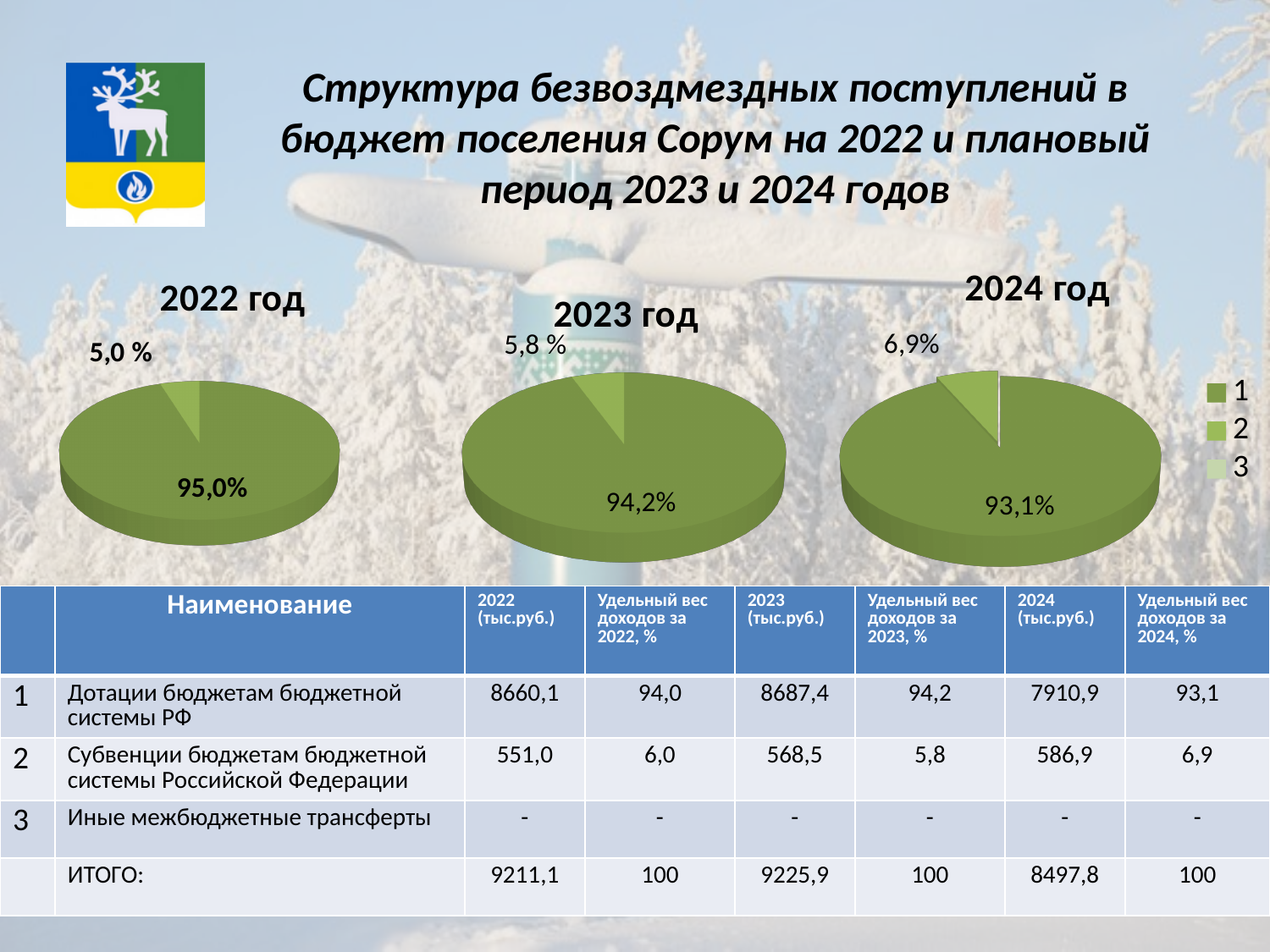
Which of the three pie charts has the largest small slice: 2022 год, 2023 год or 2024 год? 2024 год In the 2024 год pie chart, what is the value of the smaller slice? 6,9% In the 2023 год pie chart, what is the value of the smaller slice? 5,8 % Does the share of the larger slice rise or fall from the 2022 год chart to the 2024 год chart? fall In the 2024 год pie chart, what is the difference between the larger and smaller slice values? 86,2% In the 2022 год pie chart, what is the value of the smaller slice? 5,0 % In the 2022 год pie chart, what is the value of the larger slice? 95,0% In the 2023 год pie chart, what is the value of the larger slice? 94,2% In the 2024 год pie chart, what is the value of the larger slice? 93,1% How many entries does the legend list for the pie charts? 3 What kind of chart is used for the 2022 год chart? pie chart How many pie charts are shown on the slide? 3